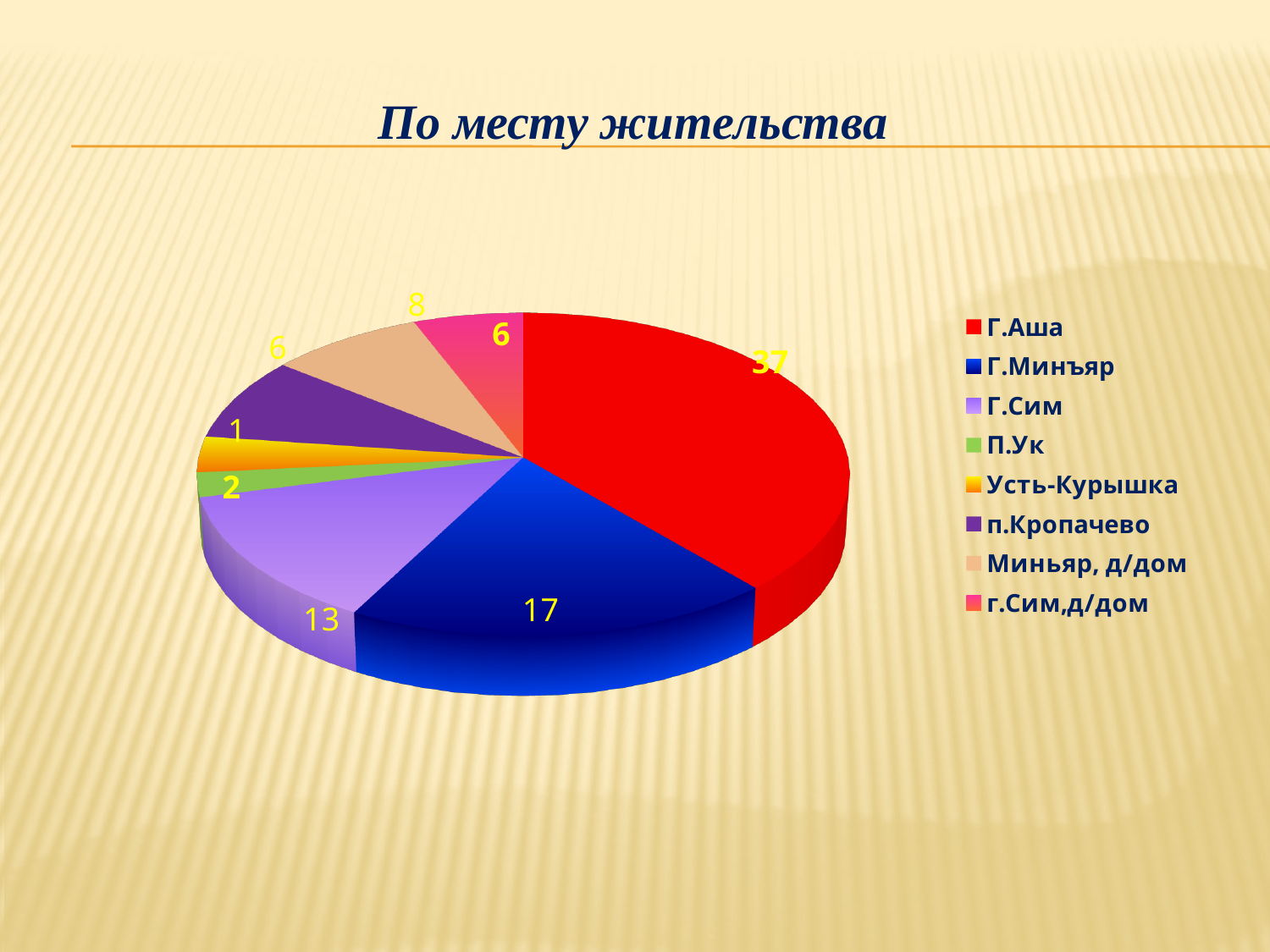
What is the difference between the values for Г.Аша and Г.Минъяр? 20 What is the title of the chart? По месту жительства What colour is the slice for Г.Минъяр? Blue What is the value for Г.Минъяр? 17 What is the value for Г.Сим? 13 What is the value for Миньяр, д/дом? 8 How many categories does the pie chart have? 8 Which category has the largest slice? Г.Аша What type of chart is shown on the slide? Pie chart What is the value for Г.Аша? 37 Which is larger, the value for П.Ук or the value for п.Кропачево? п.Кропачево